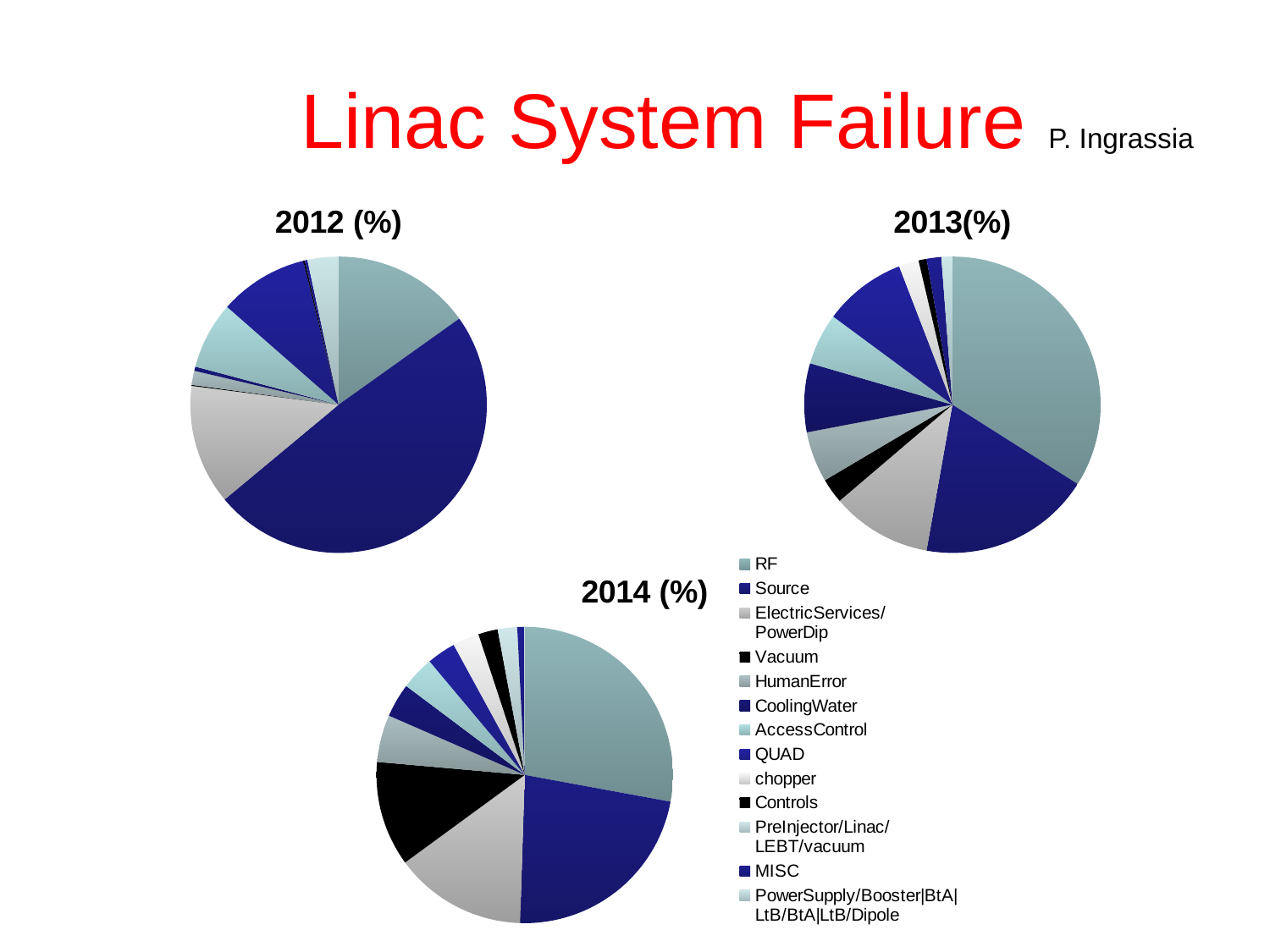
What kind of chart is used for the 2012 (%) data? pie chart How many categories does the legend list? 13 What is the title of the slide? Linac System Failure In the 2014 (%) pie chart, which category has the largest slice? RF What is the first category listed in the legend? RF In the 2013(%) pie chart, which category has the largest slice? RF How many pie charts are shown on the slide? 3 In the 2012 (%) pie chart, which category has the largest slice? Source In the 2014 (%) pie chart, which slice is larger: RF or ElectricServices/PowerDip? RF In the 2012 (%) pie chart, which slice is larger: Source or RF? Source In the 2013(%) pie chart, which slice is larger: RF or Source? RF